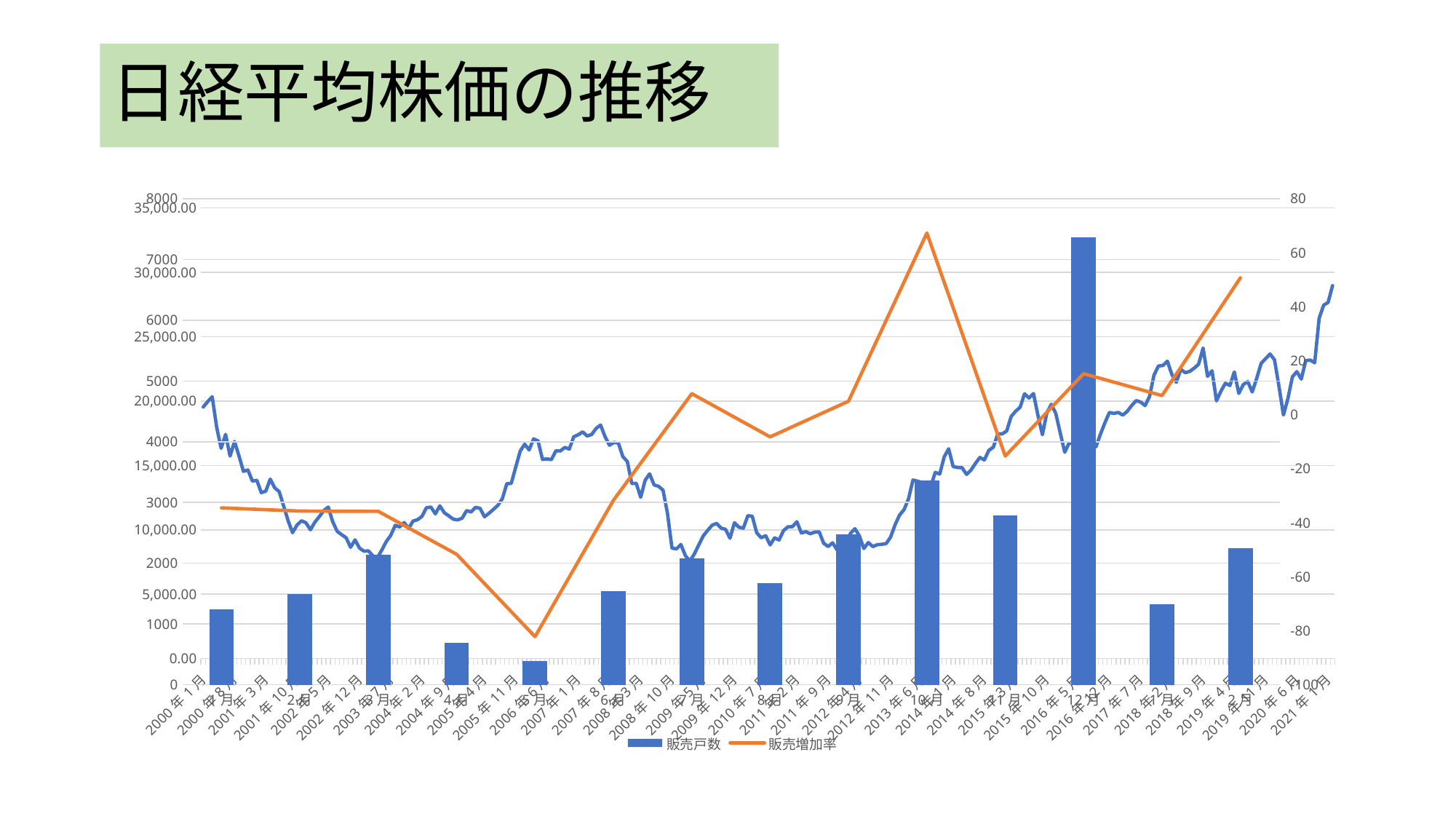
Does the 販売増加率 line rise or fall between its first point and its lowest point around 2006? fall How many series does the chart legend list? 2 Is the shortest 販売戸数 bar greater or less than 1000 on the left axis? less What kind of chart is used for the 販売増加率 series? Line chart Is the lowest point of the 販売増加率 line greater or less than -60 on the right axis? less Is the tallest 販売戸数 bar greater or less than 6000 on the left axis? greater How many bars are plotted for 販売戸数? 14 What is the title of the slide containing the chart? 日経平均株価の推移 What are the two series named in the legend? 販売戸数 and 販売増加率 What kind of chart is used for the 販売戸数 series? Bar chart